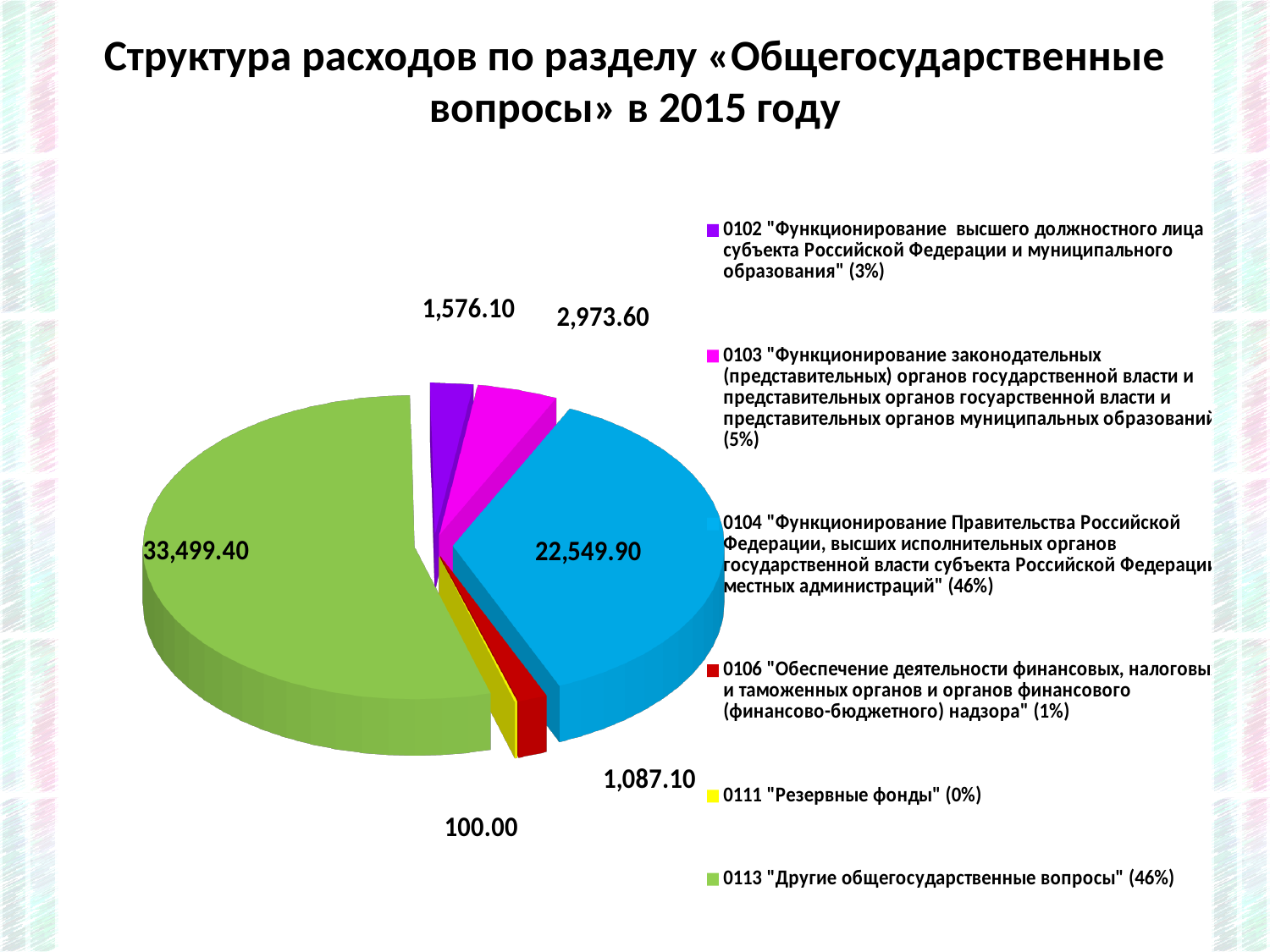
What type of chart is shown on the slide? Pie chart Which is larger: the value for 0103 or the value for 0102? 0103 What is the value for 0113 "Другие общегосударственные вопросы"? 33,499.40 What is the value for 0106 "Обеспечение деятельности финансовых, налоговых и таможенных органов..."? 1,087.10 What is the title of the chart? Структура расходов по разделу «Общегосударственные вопросы» в 2015 году Which category has the smallest slice of the pie? 0111 "Резервные фонды" What is the difference between the values for 0113 and 0104? 10,949.50 What is the value for 0111 "Резервные фонды"? 100.00 Which category has the largest slice of the pie? 0113 "Другие общегосударственные вопросы" What share of the pie does 0102 "Функционирование высшего должностного лица..." represent, according to the legend? 3% How many slices does the pie chart have? 6 What is the value for 0104 "Функционирование Правительства Российской Федерации..."? 22,549.90